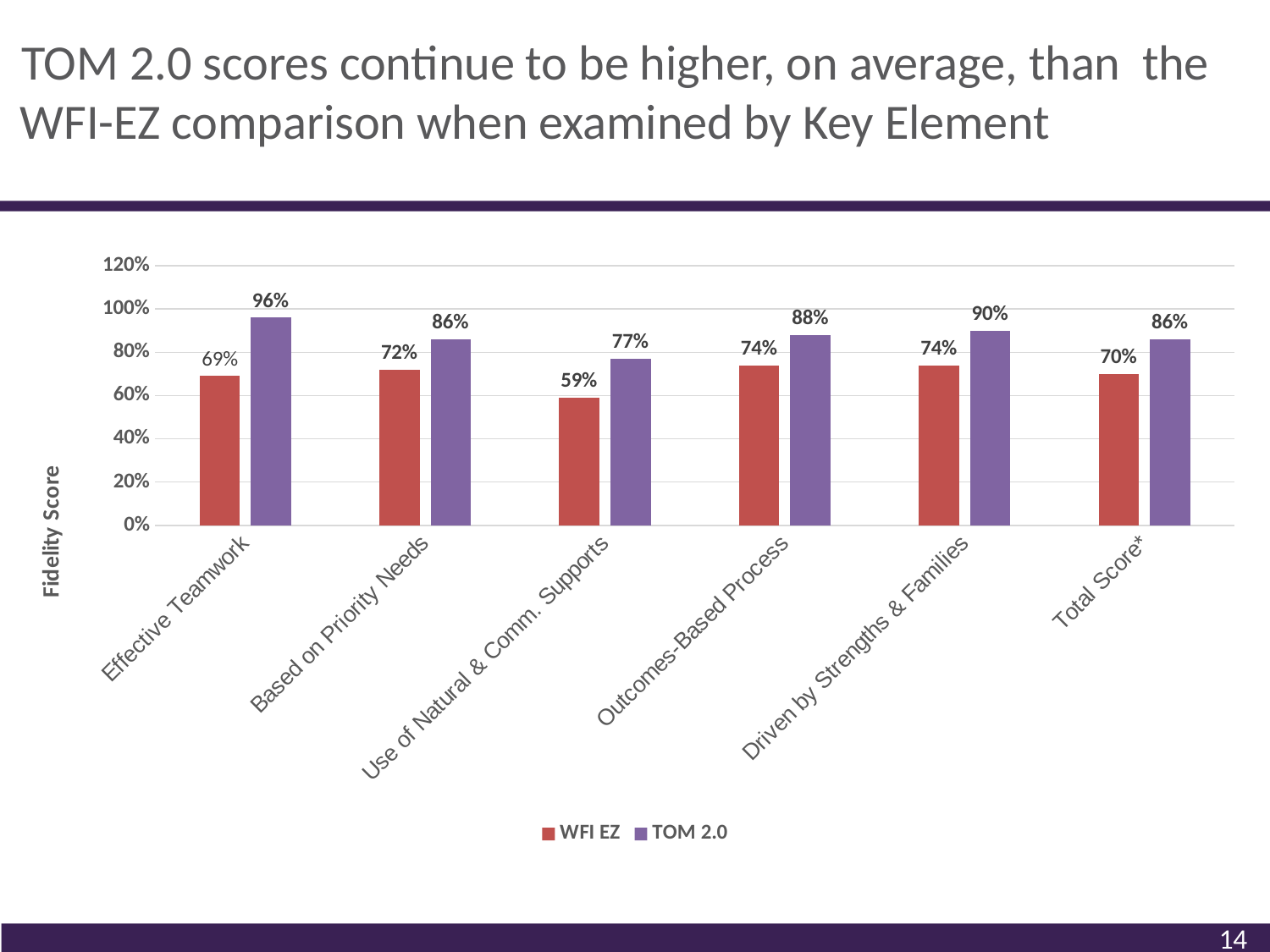
Which category has the lowest WFI EZ value? Use of Natural & Comm. Supports How many series does the legend list? 2 What is the TOM 2.0 value for Total Score*? 86% Which category has the highest TOM 2.0 value? Effective Teamwork What is the difference between the TOM 2.0 and WFI EZ values for Driven by Strengths & Families? 16% What is the label of the y axis? Fidelity Score How many categories are shown on the x axis? 6 What is the WFI EZ value for Effective Teamwork? 69% What is the difference between the TOM 2.0 and WFI EZ values for Effective Teamwork? 27% Which is larger for Outcomes-Based Process, the WFI EZ value or the TOM 2.0 value? TOM 2.0 What is the TOM 2.0 value for Use of Natural & Comm. Supports? 77% What kind of chart is shown on the slide? Bar chart